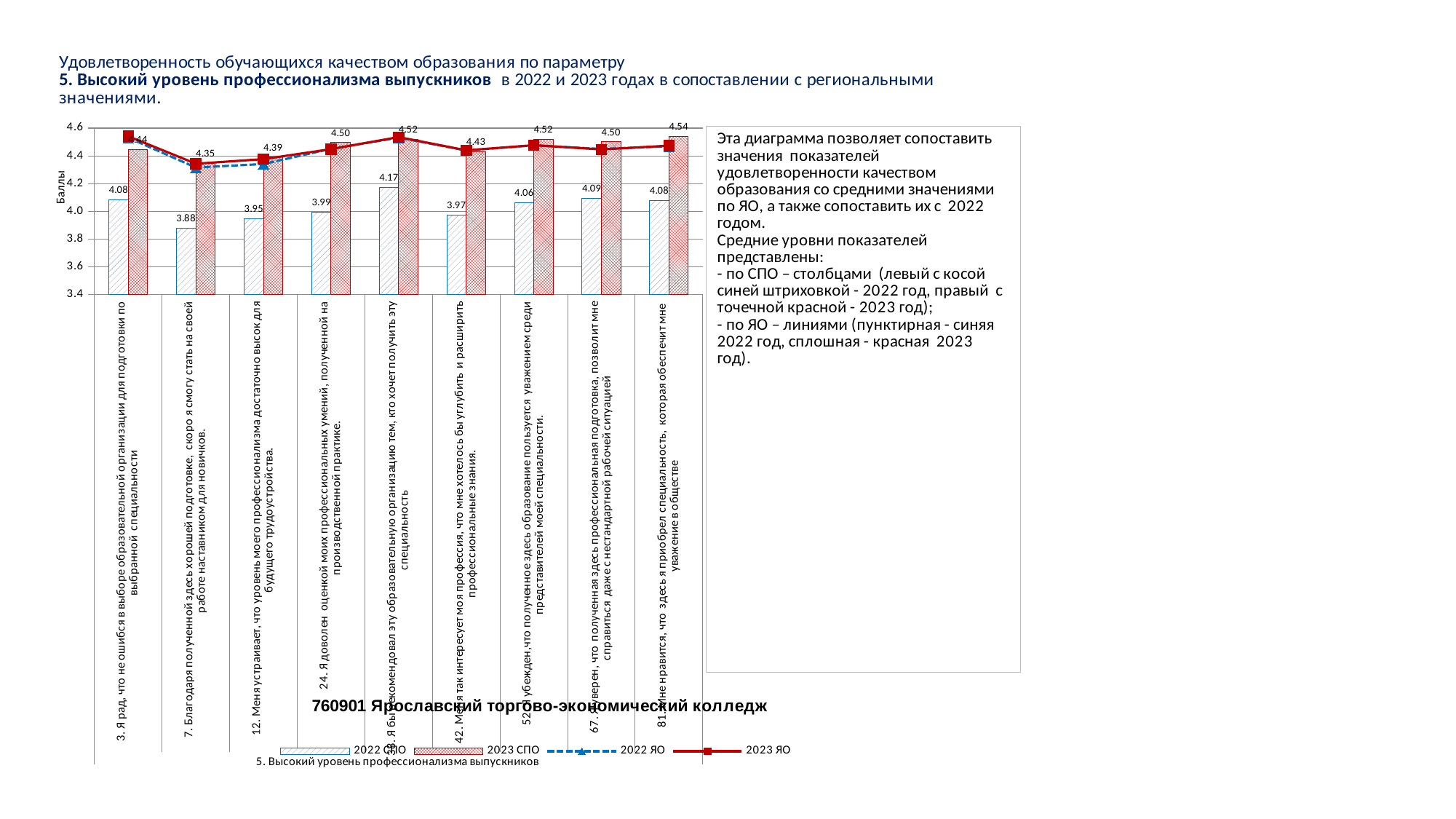
Which item has the lowest 2022 СПО value? 7. Благодаря полученной здесь хорошей подготовке, скоро я смогу стать на своей работе наставником для новичков (3.88) What is the 2023 СПО value for item 81 ("Мне нравится, что здесь я приобрел специальность...")? 4.54 What is the 2022 СПО value for item 38 ("Я бы рекомендовал эту образовательную организацию...")? 4.17 What type of chart is shown on the slide? Combined bar and line chart How many series does the chart legend list? 4 How many items (categories) are shown on the x axis of the chart? 9 Which item has the highest 2022 СПО value? 38. Я бы рекомендовал эту образовательную организацию тем, кто хочет получить эту специальность (4.17) Is the 2023 ЯО line value for item 3 greater or less than 4.4? greater Which item has the highest 2023 СПО value? 81. Мне нравится, что здесь я приобрел специальность, которая обеспечит мне уважение в обществе (4.54) Which is larger, the 2022 СПО value for item 38 or for item 42? Item 38 (4.17) What is the difference between the 2023 СПО and 2022 СПО values for item 7? 0.47 What is the 2023 СПО value for item 7 ("Благодаря полученной здесь хорошей подготовке...")? 4.35